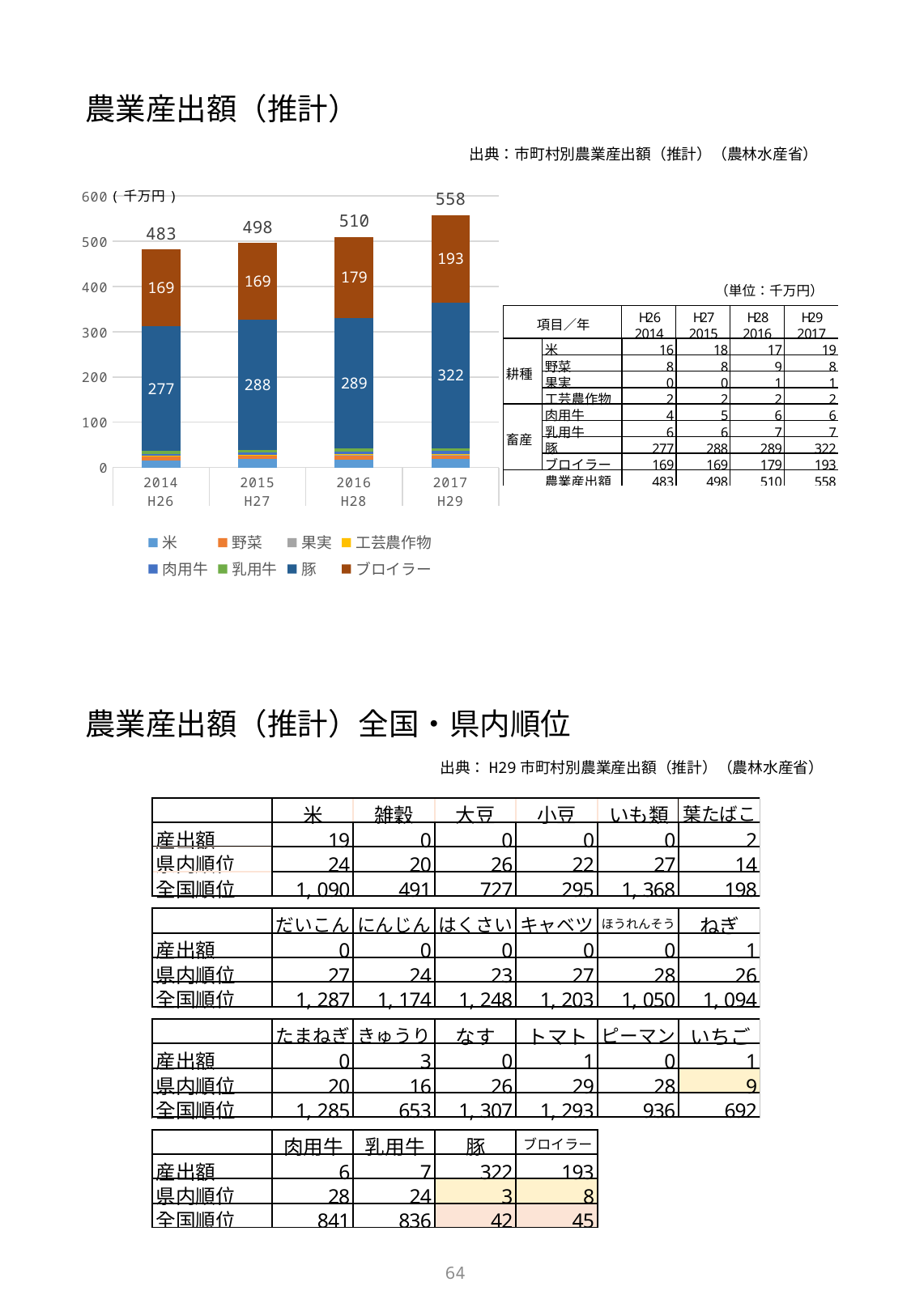
Which year has the lowest total agricultural output in the chart? 2014 (H26) Do the total values rise or fall from 2014 to 2017 in the chart? Rise What is the value of 豚 (pig) in 2014 (H26) in the chart? 277 Which year has the highest total agricultural output in the chart? 2017 (H29) How many series does the chart legend list? 8 What type of chart is shown on the slide? Stacked bar chart What is the difference between the total for 2017 and the total for 2016 in the chart? 48 Which is larger in 2015: the value for 豚 or the value for ブロイラー? 豚 What is the total agricultural output (農業産出額) shown above the bar for 2017 (H29)? 558 How many years (bars) are shown on the x axis of the chart? 4 What is the value of ブロイラー (broiler) in 2016 (H28) in the chart? 179 What is the difference between the 豚 value in 2017 and the 豚 value in 2016? 33